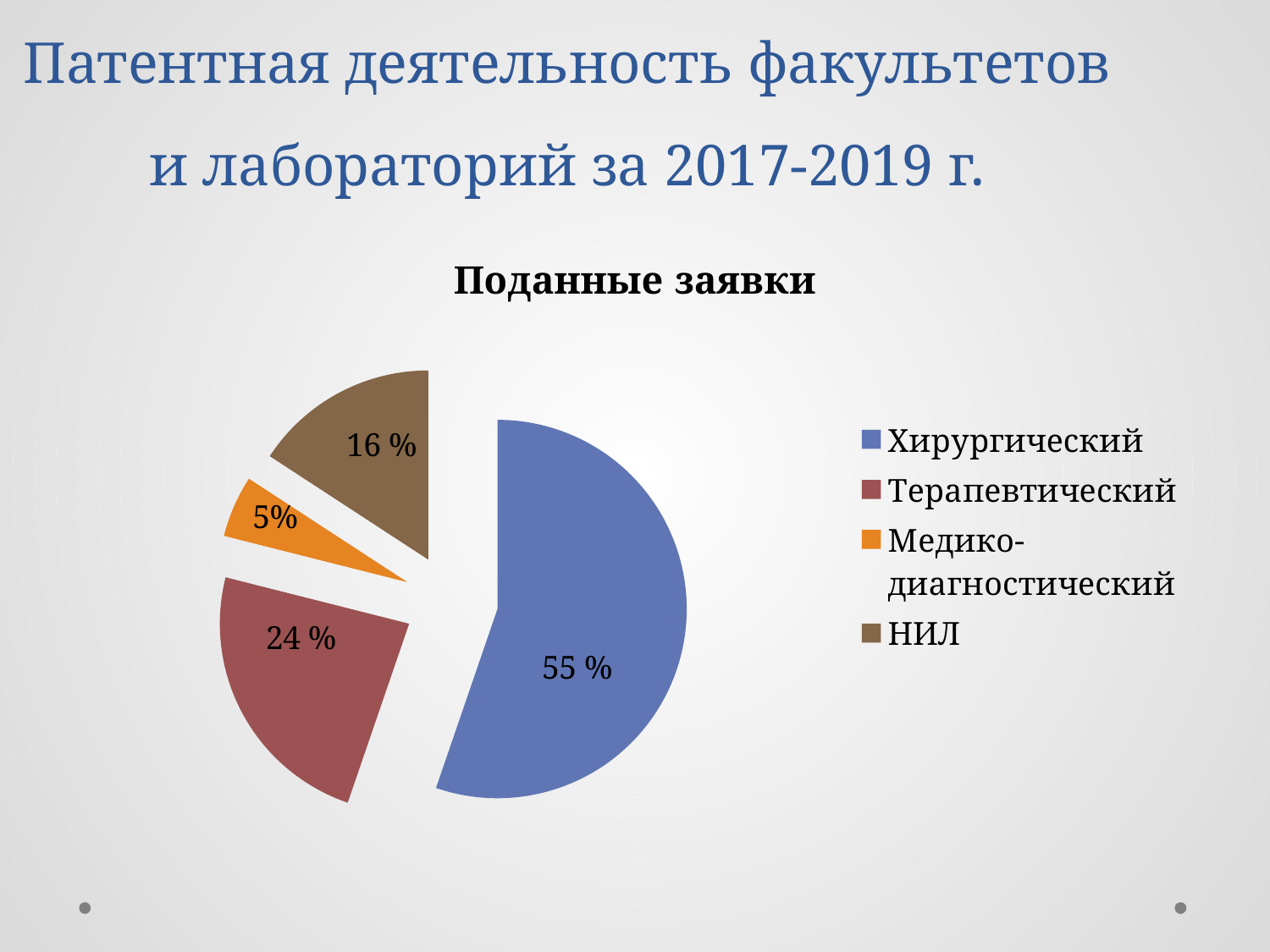
What is the difference in percentage points between Хирургический and Терапевтический? 31 What is the difference in percentage points between НИЛ and Медико-диагностический? 11 How many categories are shown in the pie chart? 4 What is the title of the chart? Поданные заявки Which is larger, the share for Терапевтический or the share for НИЛ? Терапевтический Which category has the smallest slice of the pie? Медико-диагностический What share of the pie does Терапевтический have? 24 % What share of the pie does Медико-диагностический have? 5% What share of the pie does Хирургический have? 55 % What kind of chart is shown on the slide? Pie chart What share of the pie does НИЛ have? 16 % Which category has the largest slice of the pie? Хирургический